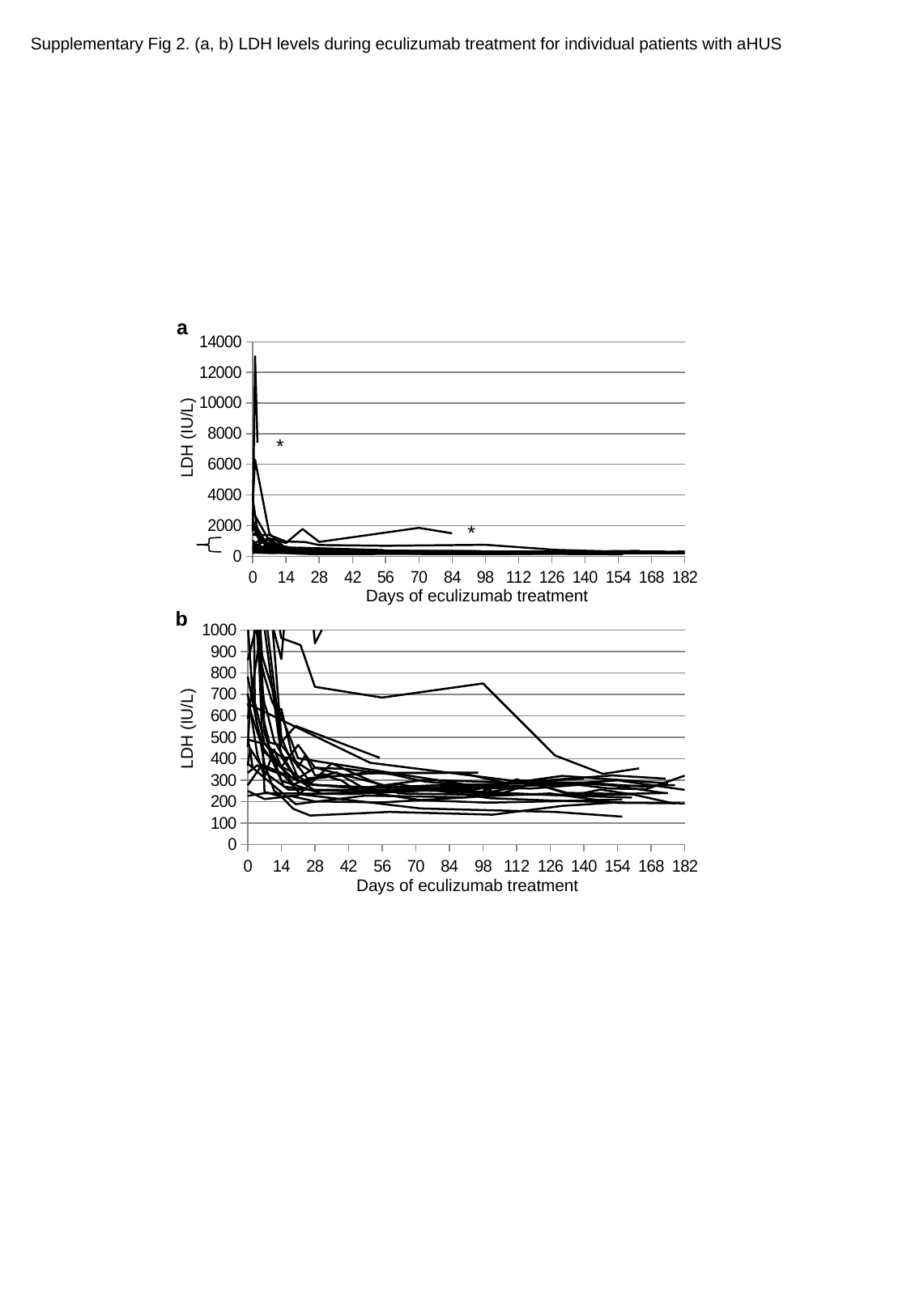
In chart b (the bottom chart), what is the label on the x axis? Days of eculizumab treatment What kind of chart is chart a (the top chart)? line chart In chart a (the top chart), do the LDH values generally rise or fall as days of eculizumab treatment increase? fall What kind of chart is chart b (the bottom chart)? line chart In chart b (the bottom chart), is the highest LDH value at day 182 greater or less than 400? less In chart a (the top chart), are the LDH values at day 182 greater or less than 2000? less In chart b (the bottom chart), do the LDH values generally rise or fall over the first 28 days of treatment? fall In chart a (the top chart), is the highest peak LDH value greater or less than 12000? greater In chart a (the top chart), what is the label on the y axis? LDH (IU/L)